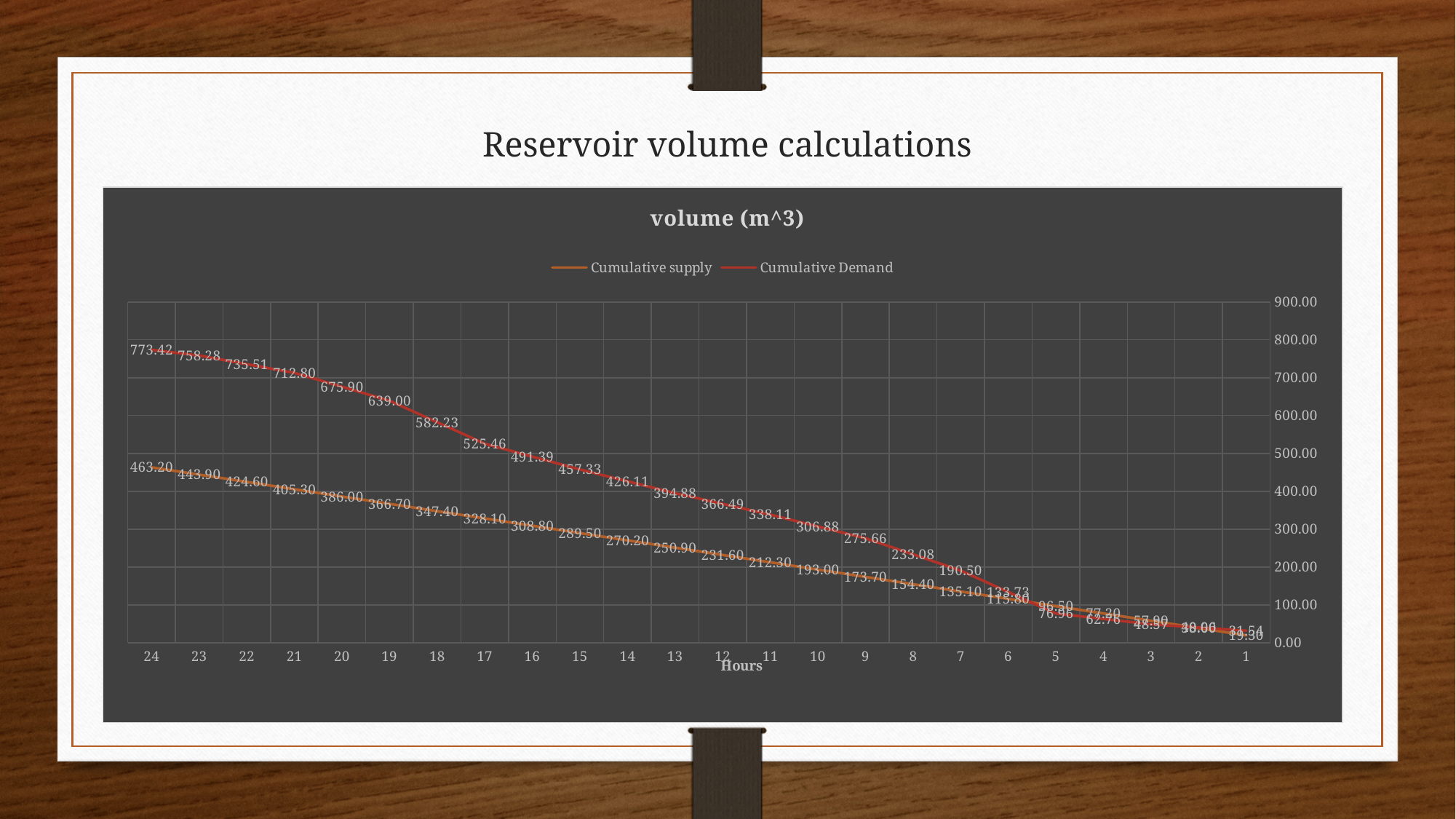
What is the Cumulative Demand value at hour 18? 582.23 What is the difference between Cumulative Demand and Cumulative supply at hour 24? 310.22 Do the Cumulative Demand values rise or fall moving from hour 24 to hour 1 along the x axis? fall At which hour is the Cumulative Demand value highest? 24 What is the title of the chart? volume (m^3) Which is larger at hour 12, Cumulative Demand or Cumulative supply? Cumulative Demand What is the Cumulative Demand value at hour 24? 773.42 What is the Cumulative supply value at hour 10? 193.00 How many series does the legend list? 2 What type of chart is shown on the slide? line chart What is the Cumulative supply value at hour 24? 463.20 How many hour categories are plotted along the x axis? 24